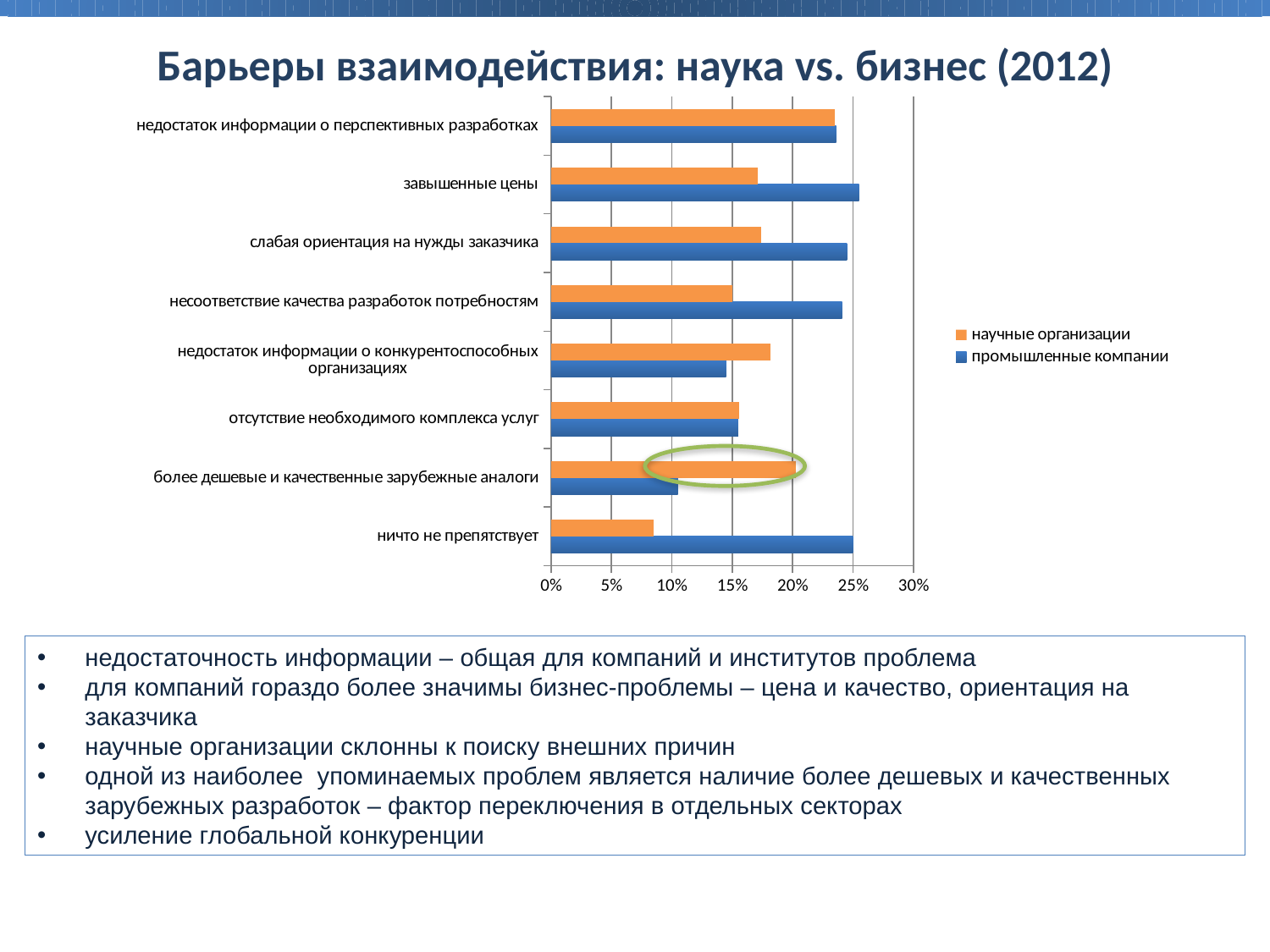
For the category 'более дешевые и качественные зарубежные аналоги', is the value for промышленные компании greater or less than 15%? less Which series is shown in orange in the legend? научные организации For the category 'недостаток информации о перспективных разработках', is the value for научные организации greater or less than 20%? greater Which category has the highest value for научные организации? недостаток информации о перспективных разработках How many series does the legend list? 2 What kind of chart is shown on the slide? bar chart Which category has the lowest value for промышленные компании? более дешевые и качественные зарубежные аналоги For the category 'завышенные цены', is the value for промышленные компании greater or less than 20%? greater What is the title of the slide containing the chart? Барьеры взаимодействия: наука vs. бизнес (2012) How many categories (barriers) are plotted on the chart? 8 For the category 'ничто не препятствует', which series has the larger value: научные организации or промышленные компании? промышленные компании